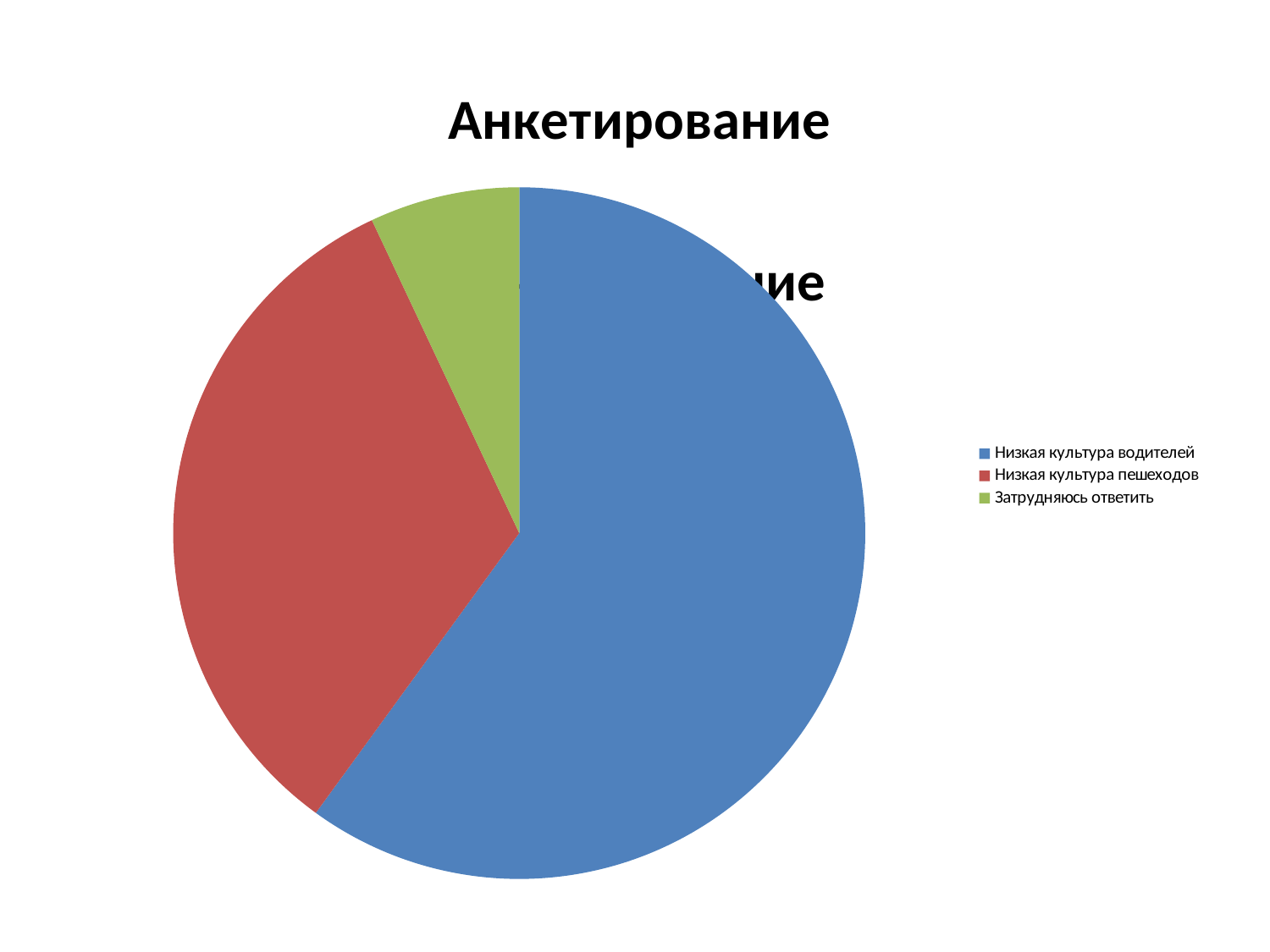
What kind of chart is shown on the slide? Pie chart Which slice is larger: Низкая культура водителей or Низкая культура пешеходов? Низкая культура водителей Which category has the largest slice of the pie? Низкая культура водителей Which category is shown in red? Низкая культура пешеходов What is the title of the chart? Анкетирование How many entries does the legend list? 3 What colour is the slice for Затрудняюсь ответить? Green Which category has the smallest slice of the pie? Затрудняюсь ответить Which slice is larger: Низкая культура пешеходов or Затрудняюсь ответить? Низкая культура пешеходов How many slices does the pie chart have? 3